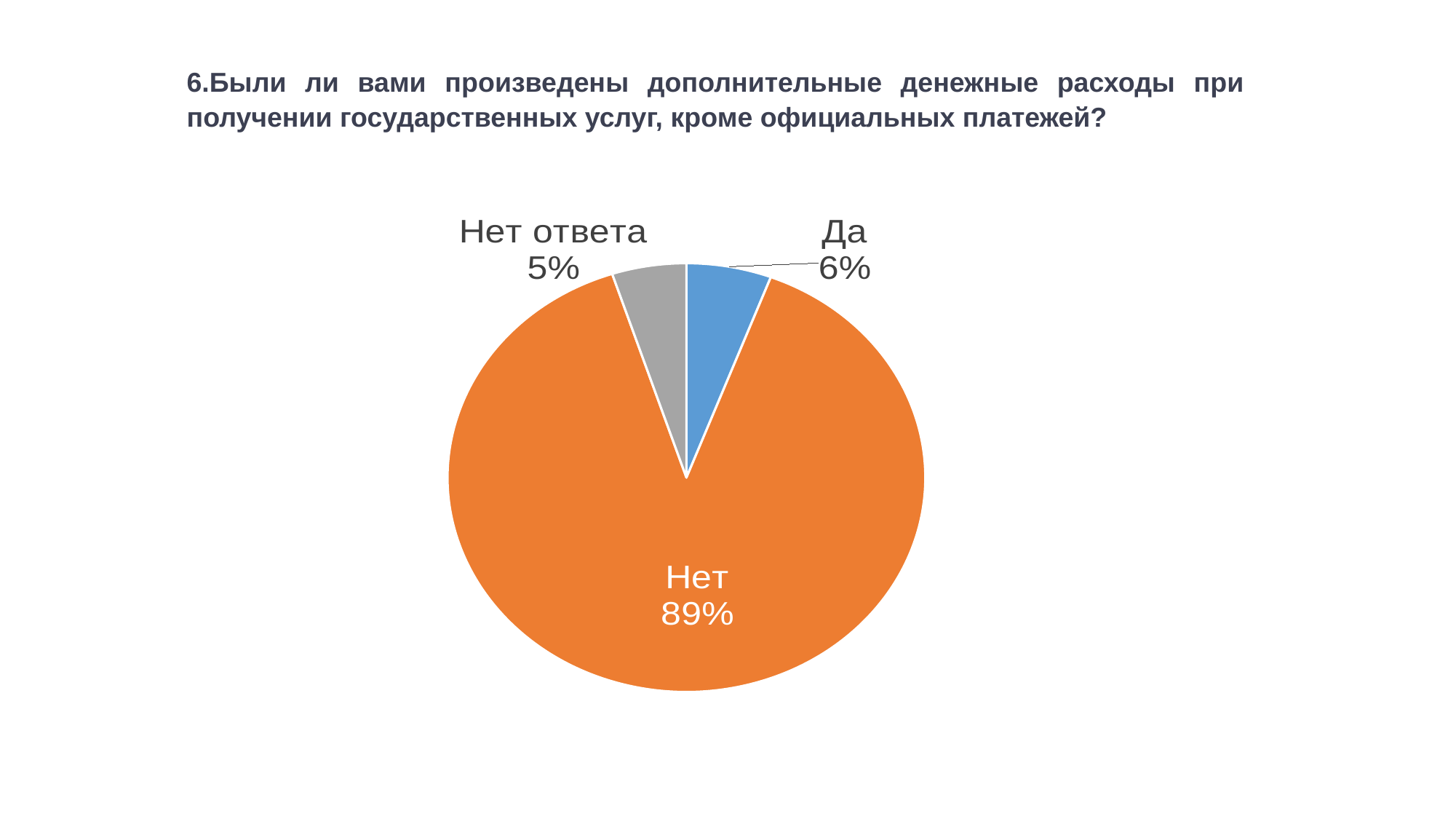
What share of the pie does the "Нет ответа" slice represent? 5% Which slice of the pie is the smallest? Нет ответа How many slices does the pie chart have? 3 Which slice of the pie is the largest? Нет What colour is the "Да" slice of the pie? blue What share of the pie does the "Нет" slice represent? 89% What share of the pie does the "Да" slice represent? 6% What colour is the "Нет" slice of the pie? orange Which is larger, the "Да" slice or the "Нет ответа" slice? Да What is the difference in percentage points between the "Да" slice and the "Нет ответа" slice? 1 What kind of chart is shown on the slide? pie chart What is the difference in percentage points between the "Нет" slice and the "Да" slice? 83